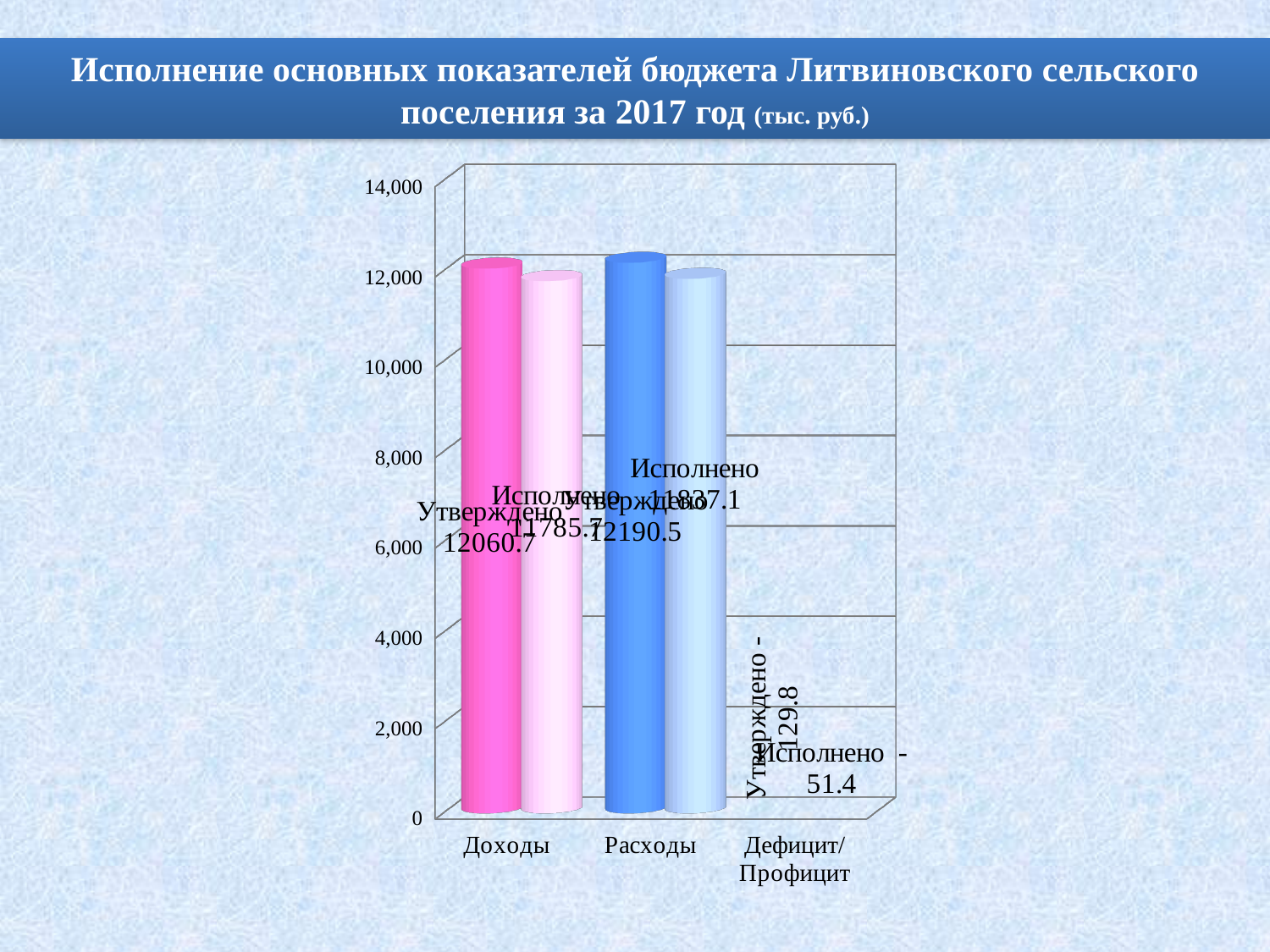
Which is larger: the approved value for Доходы or the approved value for Расходы? Расходы How many categories are shown on the x axis of the chart? 3 Is the executed (Исполнено) value for Доходы greater or less than 12,000? less By how much does the approved value for Доходы exceed the executed value for Доходы? 275.0 What is the approved (Утверждено) value for Расходы? 12190.5 What is the executed (Исполнено) value for Расходы? 11837.1 What is the approved (Утверждено) value for Доходы? 12060.7 By how much does the approved value for Расходы exceed the executed value for Расходы? 353.4 What kind of chart is shown on the slide? bar chart What is the executed (Исполнено) value for Доходы? 11785.7 What is the approved (Утверждено) value for Дефицит/Профицит? -129.8 What is the executed (Исполнено) value for Дефицит/Профицит? -51.4